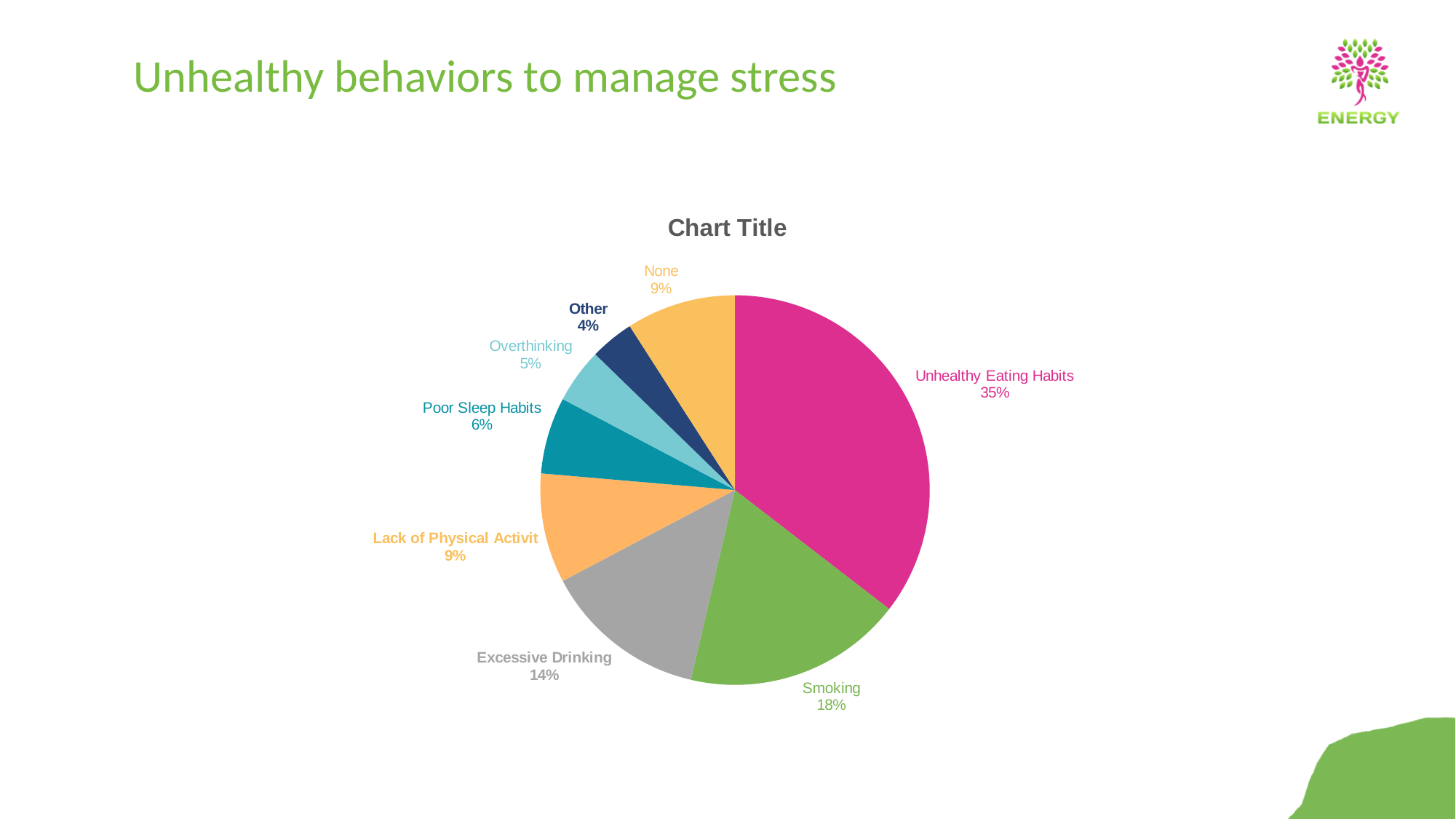
What is the difference between the Overthinking and Other shares? 1% Which category has the largest slice of the pie? Unhealthy Eating Habits What kind of chart is shown on the slide? pie chart What is the title printed above the pie chart? Chart Title What is the difference between the Unhealthy Eating Habits and Smoking shares? 17% Which category has the smallest slice of the pie? Other How many categories are shown in the pie chart? 8 What share of the pie is Unhealthy Eating Habits? 35% What is the value for Excessive Drinking? 14% What is the value for Smoking? 18% What is the value for Poor Sleep Habits? 6% Which is larger, Excessive Drinking or Lack of Physical Activit? Excessive Drinking